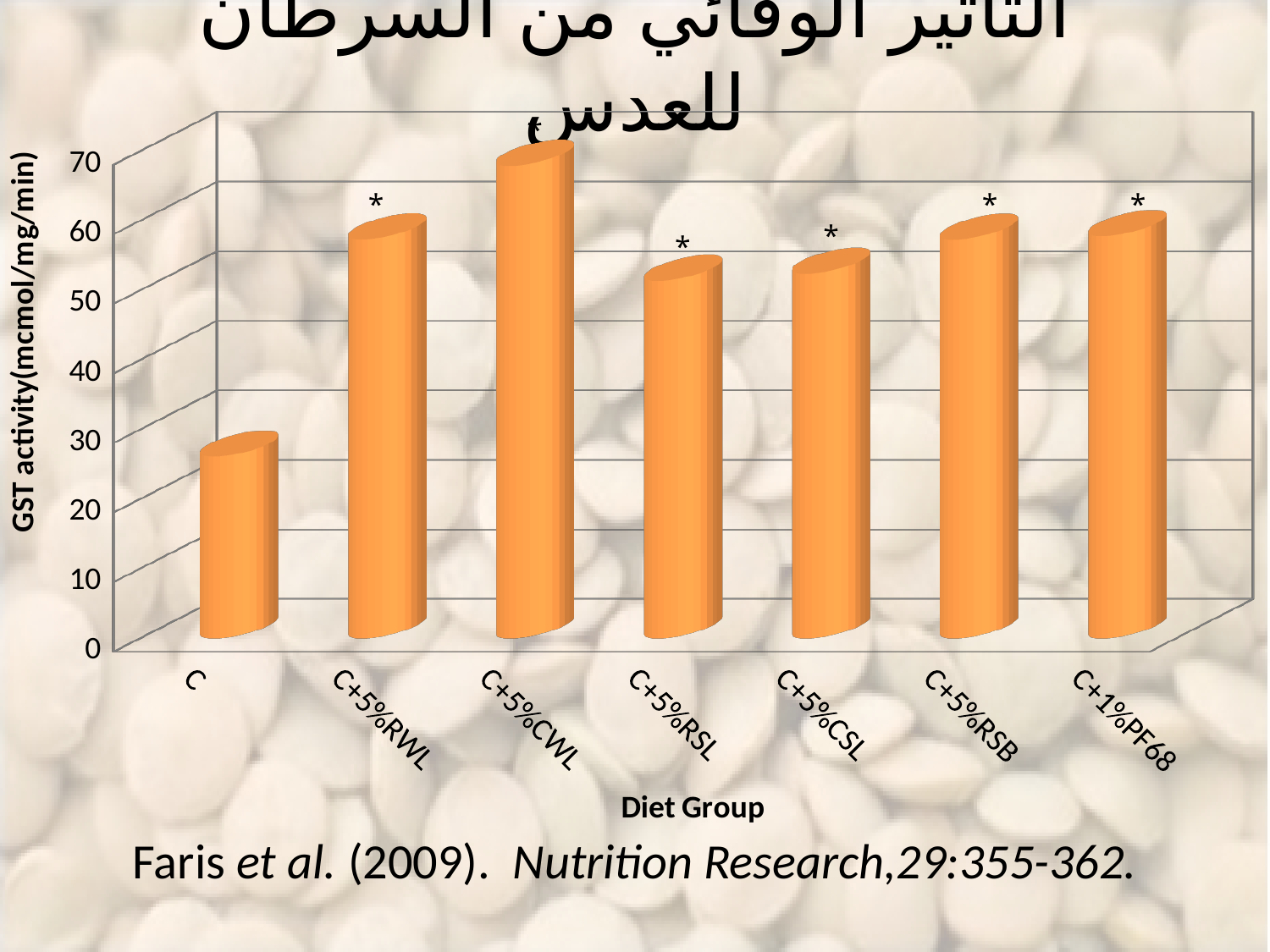
Which diet group has the highest GST activity? C+5%CWL Is the GST activity for C greater or less than 40? less Is the GST activity for C+5%RWL greater or less than 50? greater How many diet groups are shown on the x axis of the chart? 7 What kind of chart is shown on the slide? bar chart Which diet group has the lowest GST activity? C Which has higher GST activity, C or C+5%RSB? C+5%RSB What is the title of the horizontal axis of the chart? Diet Group Is the GST activity for C+5%RSL greater or less than 60? less Which has higher GST activity, C+5%CWL or C+5%RSL? C+5%CWL What is the title of the vertical axis of the chart? GST activity(mcmol/mg/min)